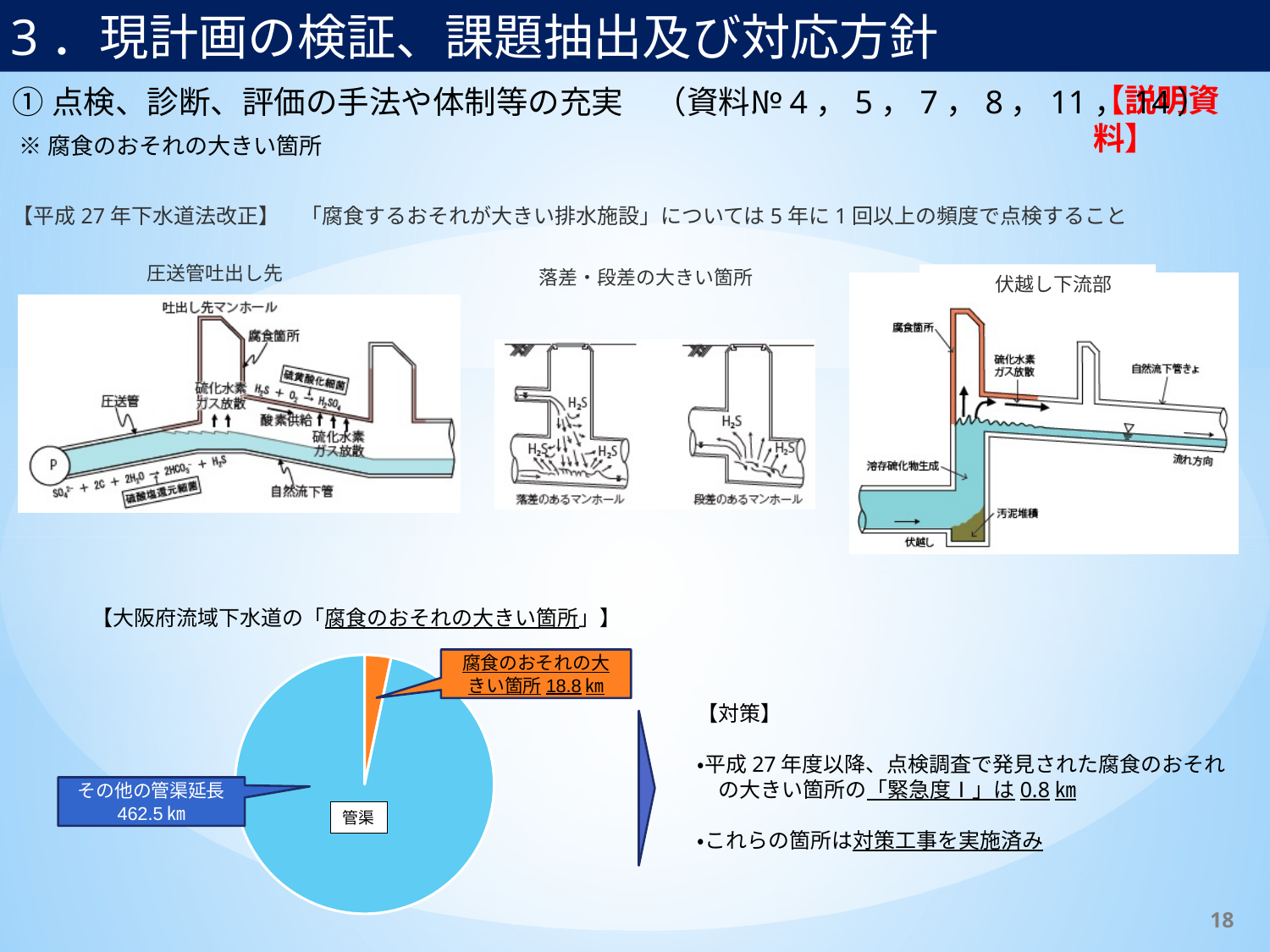
What kind of chart is shown at the bottom left of the slide? Pie chart How many slices does the pie chart have? 2 What is the title written above the pie chart? 【大阪府流域下水道の「腐食のおそれの大きい箇所」】 Which slice of the pie chart is the smallest? 腐食のおそれの大きい箇所 What is the difference between その他の管渠延長 (462.5 km) and 腐食のおそれの大きい箇所 (18.8 km) in the pie chart? 443.7 km Which slice of the pie chart is the largest? その他の管渠延長 In the pie chart, what is the value for 腐食のおそれの大きい箇所? 18.8 km In the pie chart, which is larger: その他の管渠延長 or 腐食のおそれの大きい箇所? その他の管渠延長 What is the total length represented by the two slices of the pie chart? 481.3 km In the pie chart, what is the value for その他の管渠延長? 462.5 km What colour is the slice for 腐食のおそれの大きい箇所 in the pie chart? Orange